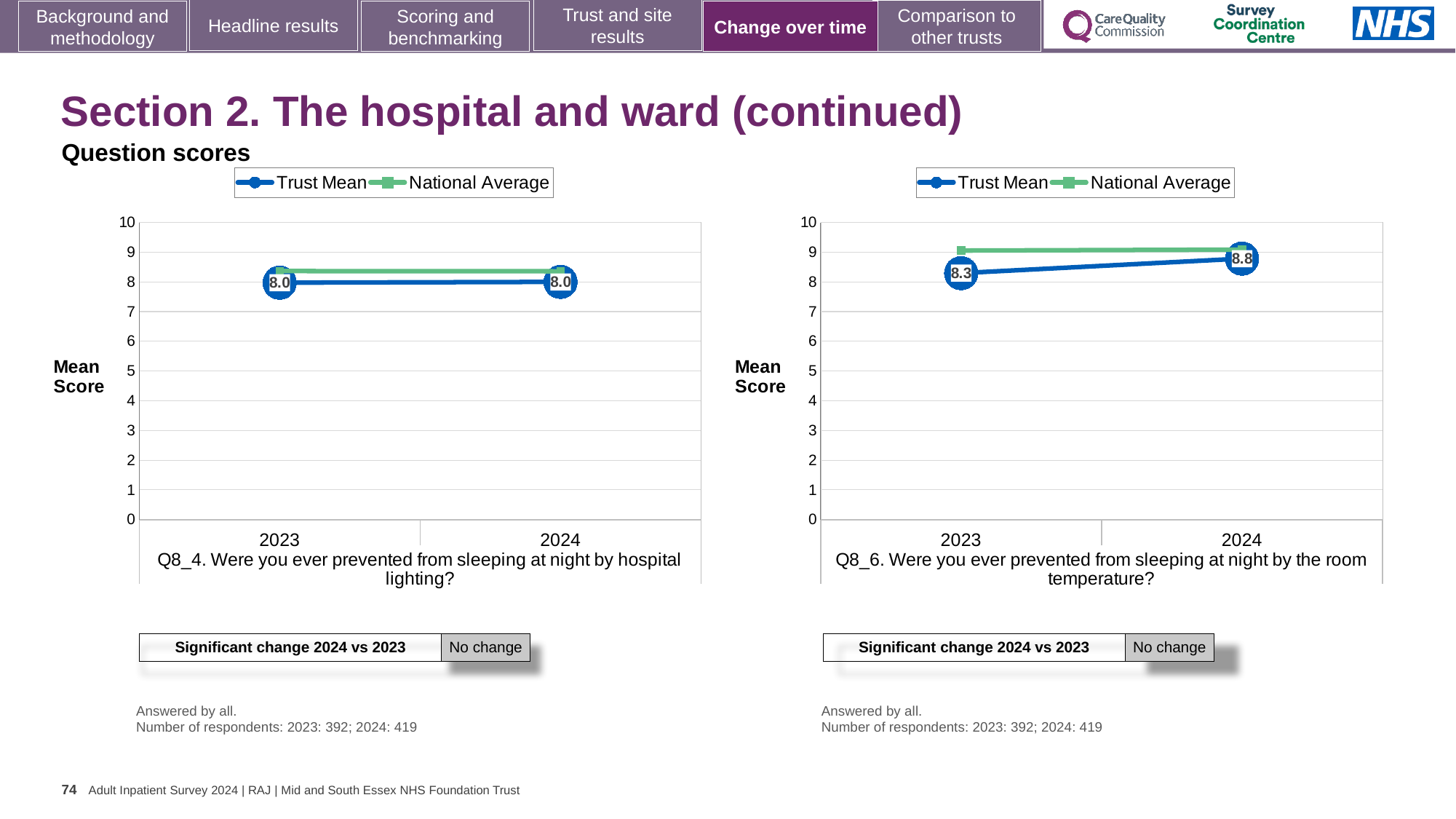
What kind of chart is the Q8_6 chart on the right? line chart How many series does the legend of the Q8_4 chart on the left list? 2 In the Q8_6 chart on the right, is the National Average for 2023 greater or less than 8? greater In the Q8_6 chart on the right, which is higher in 2023, the Trust Mean or the National Average? National Average In the Q8_4 chart on the left, what is the Trust Mean score for 2024? 8.0 In the Q8_6 chart on the right, which year has the higher Trust Mean, 2023 or 2024? 2024 In the Q8_4 chart on the left, does the Trust Mean rise, fall or stay the same from 2023 to 2024? stays the same In the Q8_4 chart on the left, what is the Trust Mean score for 2023? 8.0 In the Q8_6 chart on the right, does the Trust Mean rise or fall from 2023 to 2024? rise In the Q8_6 chart on the right, by how much did the Trust Mean change from 2023 to 2024? 0.5 In the Q8_6 chart on the right, what is the Trust Mean score for 2023? 8.3 In the Q8_6 chart on the right, what is the Trust Mean score for 2024? 8.8